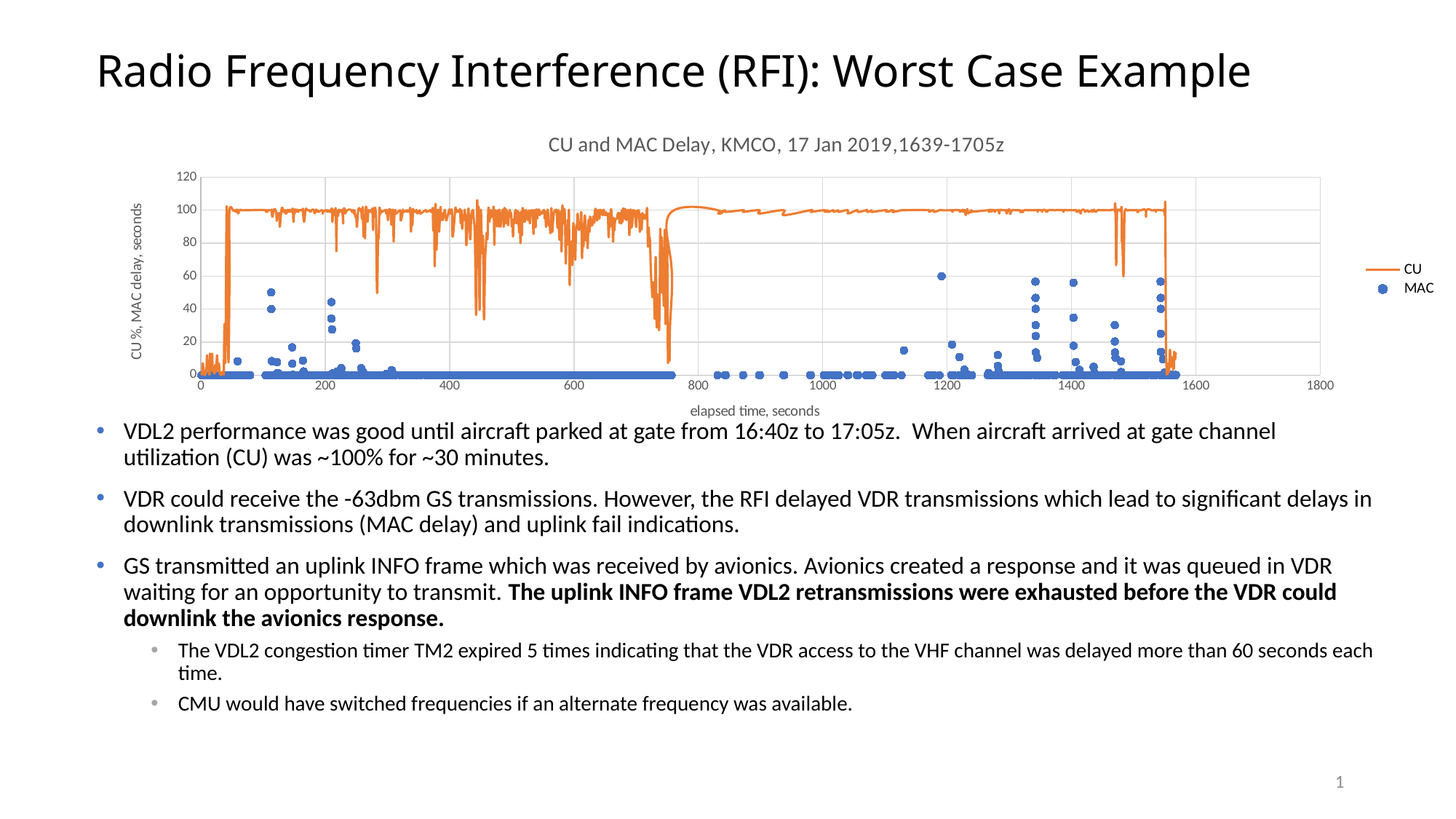
What is the title of the chart? CU and MAC Delay, KMCO, 17 Jan 2019,1639-1705z Does the CU value rise or fall between an elapsed time of 0 and 100 seconds? rise Is the highest MAC delay value plotted greater or less than 80? less Is the highest MAC delay value plotted greater or less than 40? greater Is the CU value at an elapsed time of 1000 seconds greater or less than 80? greater How many series does the chart legend list? 2 What kind of chart is shown on the slide? A line chart with scatter points What is the label of the x axis of the chart? elapsed time, seconds Which series reaches higher values on the chart, CU or MAC? CU